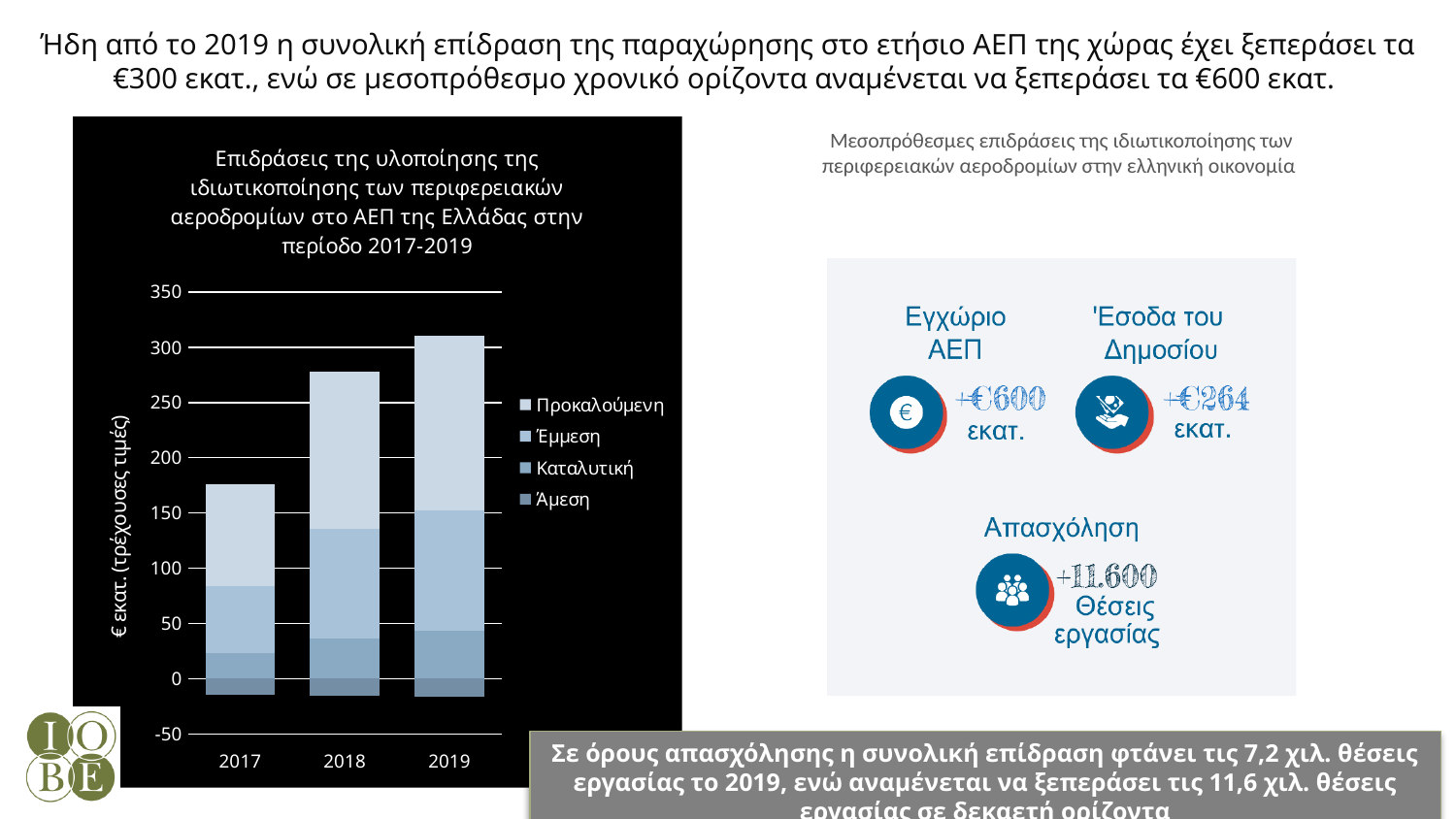
Is the top of the stacked bar for 2017 greater or less than 200? less Is the top of the stacked bar for 2019 greater or less than 350? less Which year has the tallest stacked bar in the chart? 2019 Is the top of the stacked bar for 2018 greater or less than 250? greater Which stacked bar is taller, 2018 or 2017? 2018 How many series does the legend of the bar chart list? 4 What kind of chart is shown on the left of the slide? stacked bar chart Which year has the shortest stacked bar in the chart? 2017 Do the stacked bar totals rise or fall from 2017 to 2019? rise What is the label of the y axis of the bar chart? € εκατ. (τρέχουσες τιμές) Which series is listed first in the legend of the bar chart? Προκαλούμενη How many years (categories) are shown on the x axis of the bar chart? 3